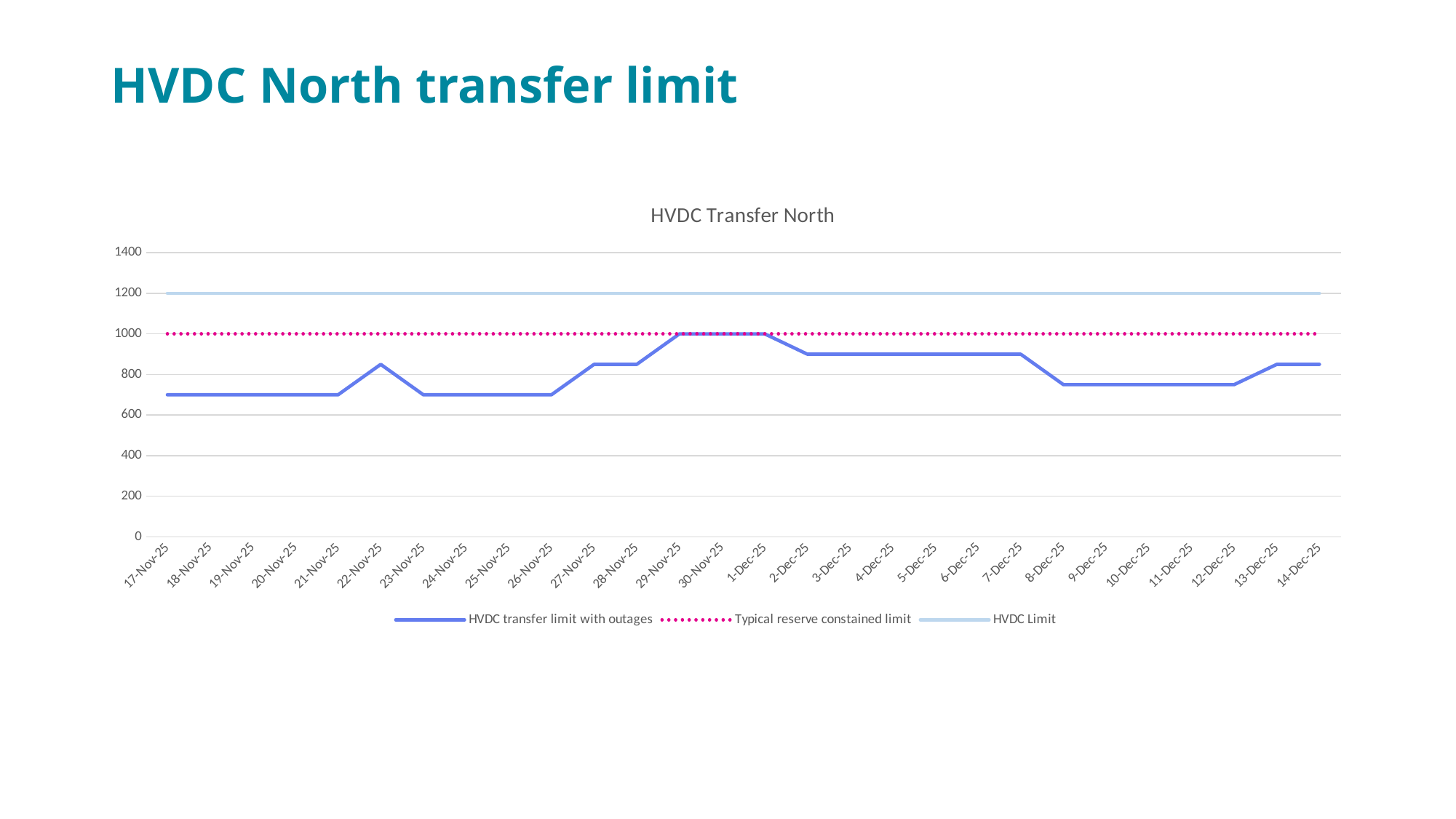
What kind of chart is shown on the slide? line chart How many dates are shown on the x axis? 28 Is the value of HVDC transfer limit with outages on 17-Nov-25 greater or less than 800? less What is the value of the HVDC Limit series? 1200 Does the HVDC transfer limit with outages rise or fall from 7-Dec-25 to 8-Dec-25? fall Which is larger for HVDC transfer limit with outages: the value on 21-Nov-25 or on 22-Nov-25? 22-Nov-25 What is the title of the chart? HVDC Transfer North What is the value of the Typical reserve constained limit series? 1000 How many series does the legend list? 3 Is the value of HVDC transfer limit with outages on 9-Dec-25 greater or less than 800? less What is the value of HVDC transfer limit with outages on 30-Nov-25? 1000 Is the value of HVDC transfer limit with outages on 3-Dec-25 greater or less than 800? greater